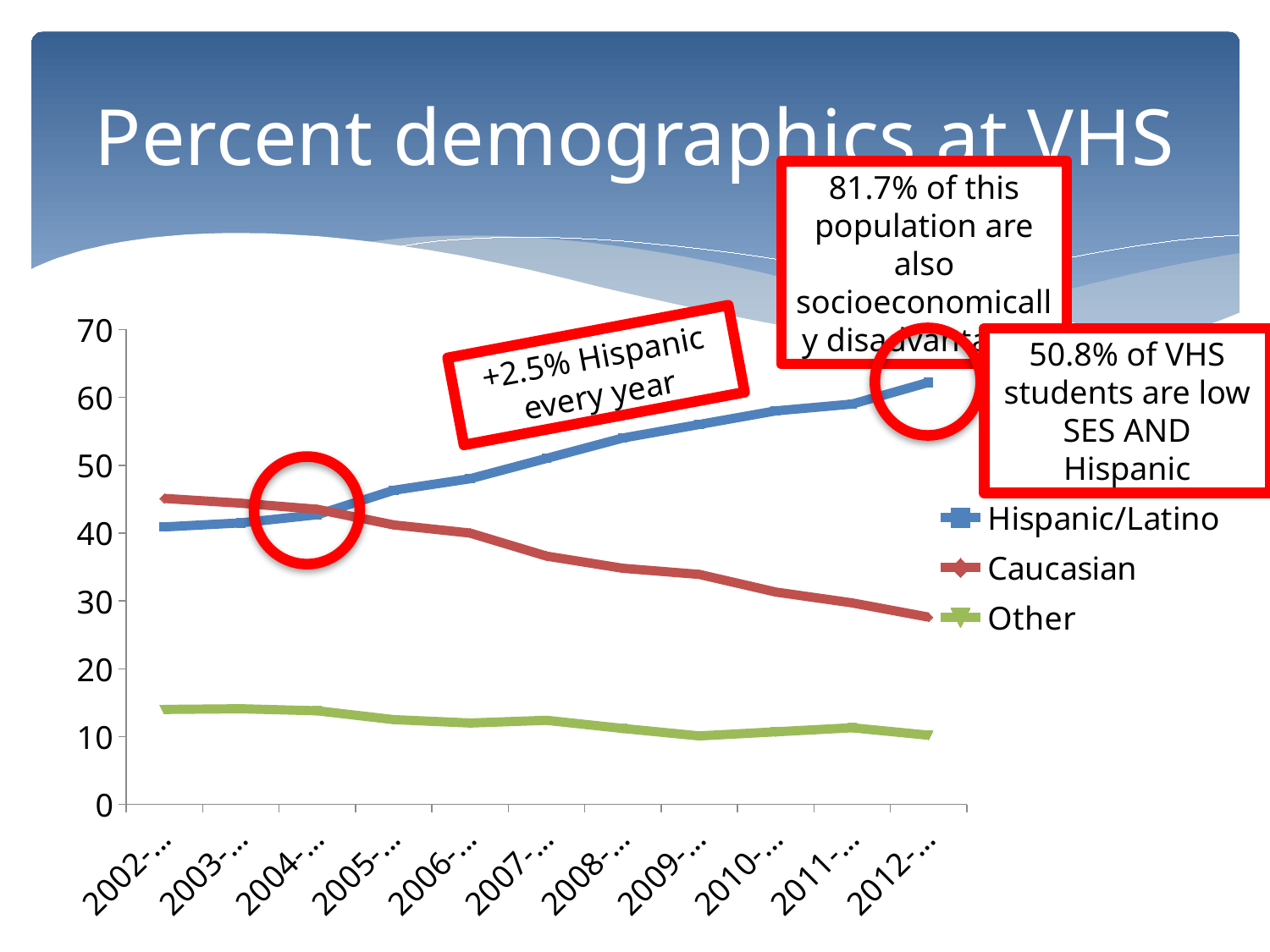
What kind of chart is shown on the slide? line chart How many series does the legend list? 3 Is the Other value for 2002 greater or less than 20? less Does the Hispanic/Latino line rise or fall from 2002 to 2012? rises Which series has the lowest value in 2012? Other How many school years are plotted along the x axis? 11 Is the Hispanic/Latino value for 2002 greater or less than 50? less Does the Caucasian line rise or fall from 2002 to 2012? falls In 2002, which is larger: the Caucasian value or the Hispanic/Latino value? Caucasian Is the Hispanic/Latino value for 2012 greater or less than 60? greater Which series has the highest value in 2012? Hispanic/Latino